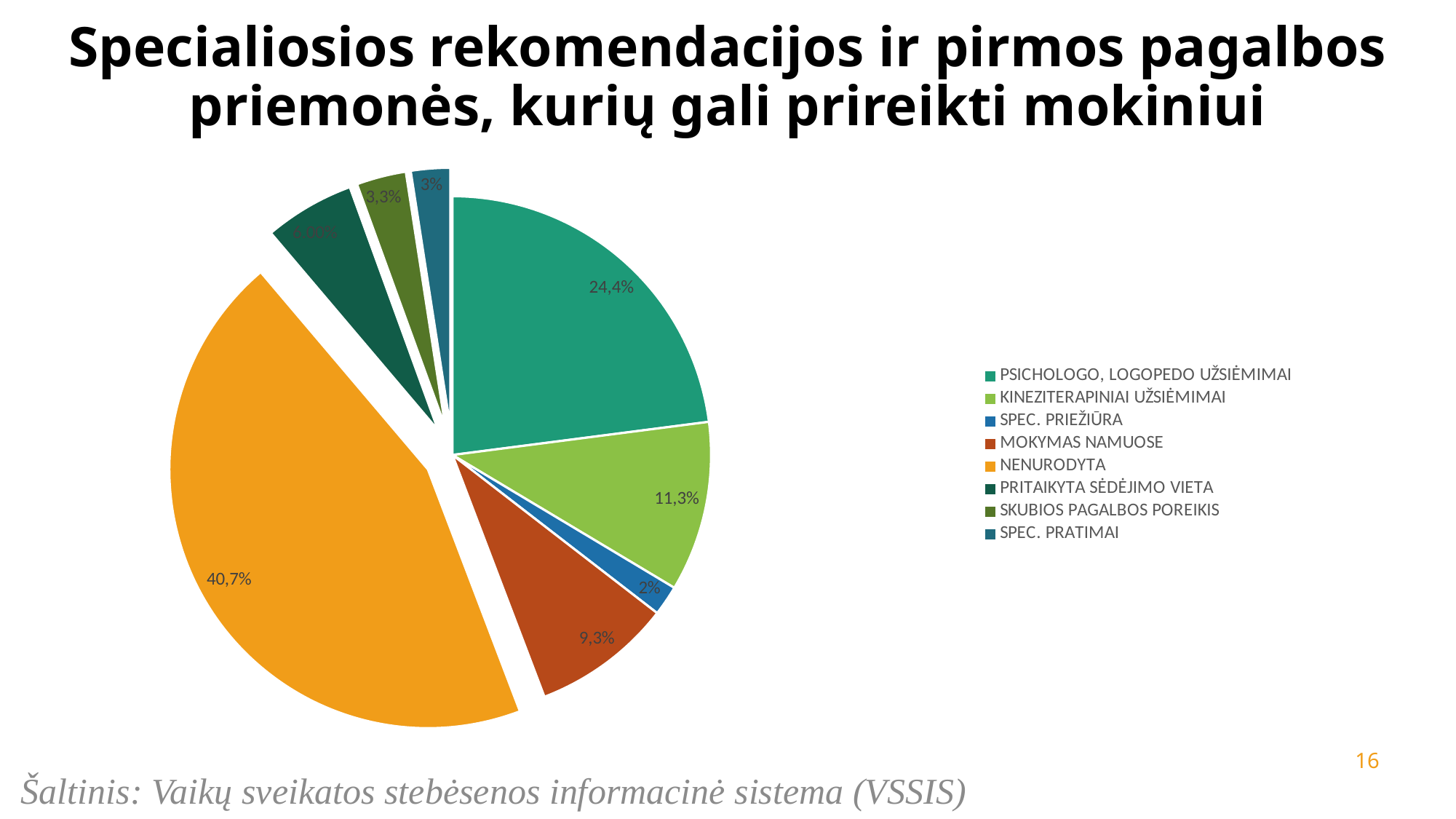
What share of the pie is labelled NENURODYTA? 40,7% How many categories does the legend of the pie chart list? 8 What kind of chart is shown on the slide? pie chart Which is larger: the slice for KINEZITERAPINIAI UŽSIĖMIMAI or the slice for MOKYMAS NAMUOSE? KINEZITERAPINIAI UŽSIĖMIMAI Which category has the smallest slice of the pie? SPEC. PRIEŽIŪRA What share of the pie is labelled MOKYMAS NAMUOSE? 9,3% What share of the pie is labelled KINEZITERAPINIAI UŽSIĖMIMAI? 11,3% What share of the pie is labelled SKUBIOS PAGALBOS POREIKIS? 3,3% What is the difference in percentage points between the NENURODYTA slice and the PSICHOLOGO, LOGOPEDO UŽSIĖMIMAI slice? 16,3 Which category has the largest slice of the pie? NENURODYTA What share of the pie is labelled SPEC. PRIEŽIŪRA? 2% What share of the pie is labelled PSICHOLOGO, LOGOPEDO UŽSIĖMIMAI? 24,4%